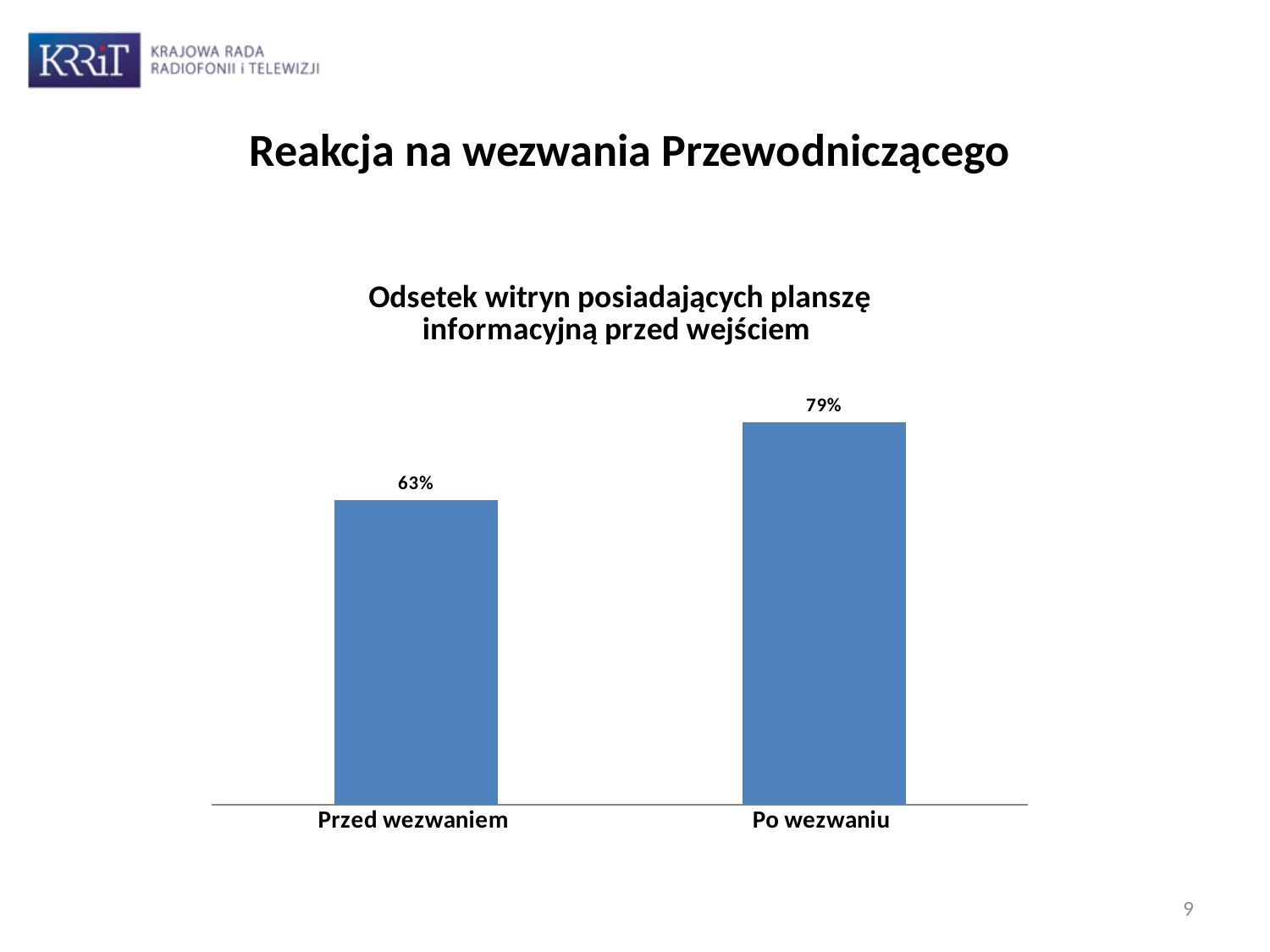
Which category has the lowest value? Przed wezwaniem Which is larger, the value for "Przed wezwaniem" or the value for "Po wezwaniu"? Po wezwaniu What is the title of the chart? Odsetek witryn posiadających planszę informacyjną przed wejściem Which category has the highest value? Po wezwaniu What is the value for "Po wezwaniu"? 79% What is the difference between the values for "Po wezwaniu" and "Przed wezwaniem"? 16% Do the values rise or fall from "Przed wezwaniem" to "Po wezwaniu"? Rise What colour are the bars in the chart? Blue What kind of chart is shown on the slide? Bar chart How many categories are shown in the chart? 2 What is the value for "Przed wezwaniem"? 63%